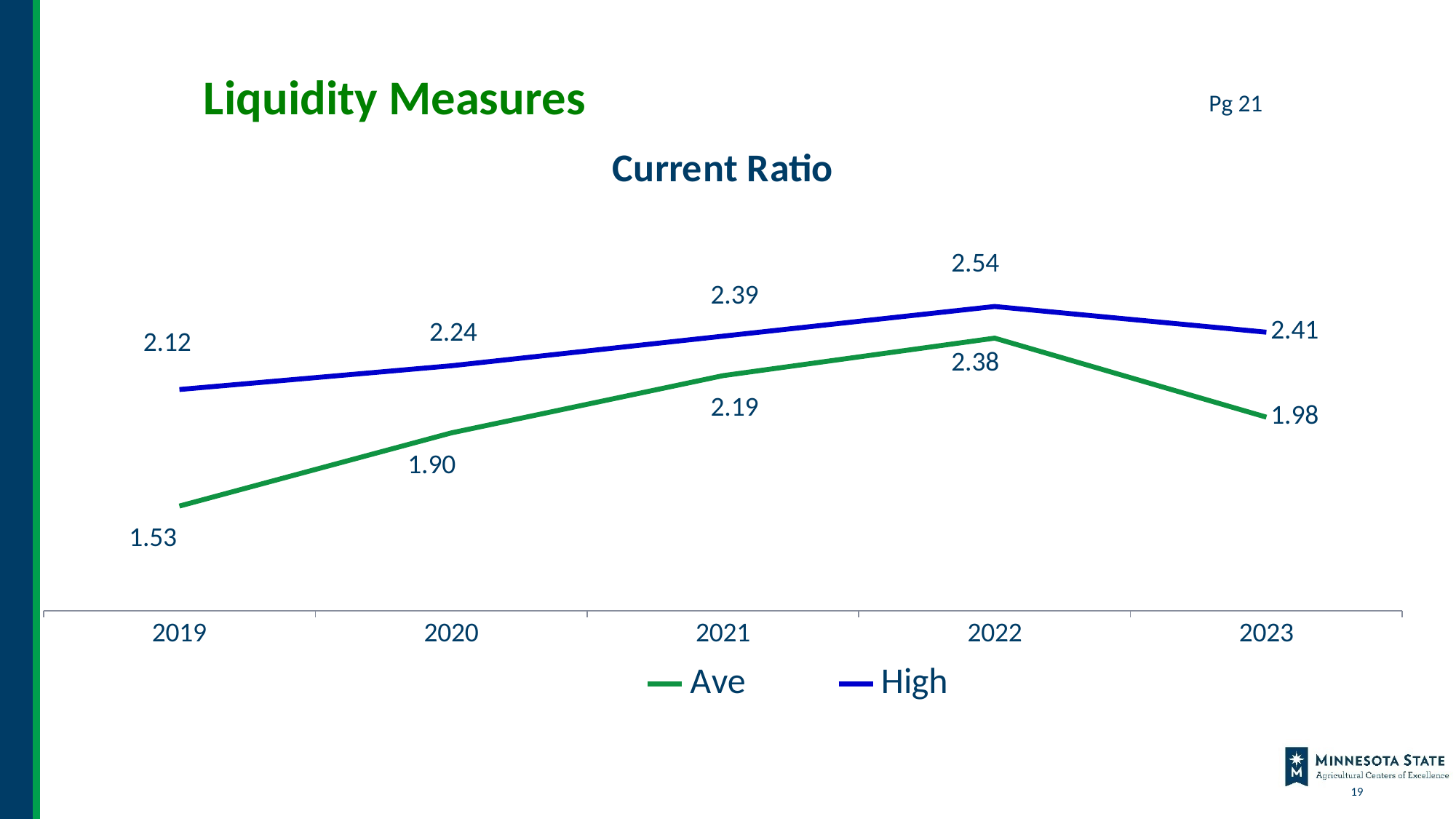
In which year is the High current ratio lowest? 2019 What is the difference between the High and Ave current ratios in 2021? 0.20 Does the Ave current ratio rise or fall from 2019 to 2022? Rise Which is larger, the Ave current ratio in 2020 or the Ave current ratio in 2023? 2023 What is the Ave current ratio in 2023? 1.98 What is the High current ratio in 2022? 2.54 What is the title of the chart? Current Ratio What kind of chart is shown? Line chart How many years are shown on the x axis? 5 How many series does the legend list? 2 In which year is the Ave current ratio highest? 2022 What is the Ave current ratio in 2019? 1.53